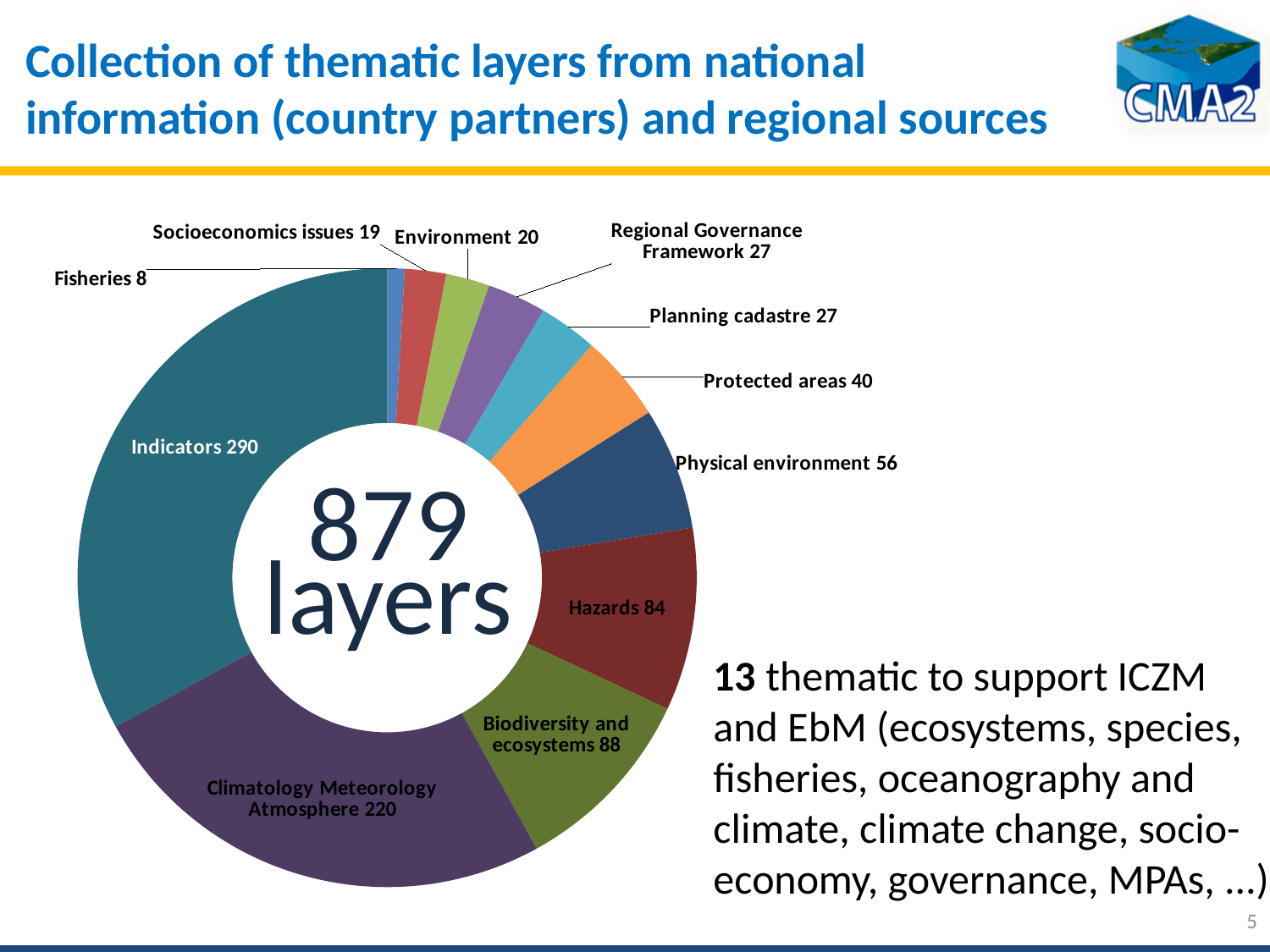
How many layers does the Indicators category have? 290 What is the difference between Indicators and Climatology Meteorology Atmosphere? 70 What is the value for Climatology Meteorology Atmosphere? 220 Which is larger, Biodiversity and ecosystems or Hazards? Biodiversity and ecosystems Which category has the smallest number of layers? Fisheries What share of the 879 layers does Indicators represent? 33% Which category has the largest number of layers? Indicators How many categories are labelled on the chart? 11 What is the value for Protected areas? 40 What type of chart is shown on the slide? Doughnut (pie) chart What is the difference between Hazards and Physical environment? 28 What total number of layers is shown in the centre of the chart? 879 layers